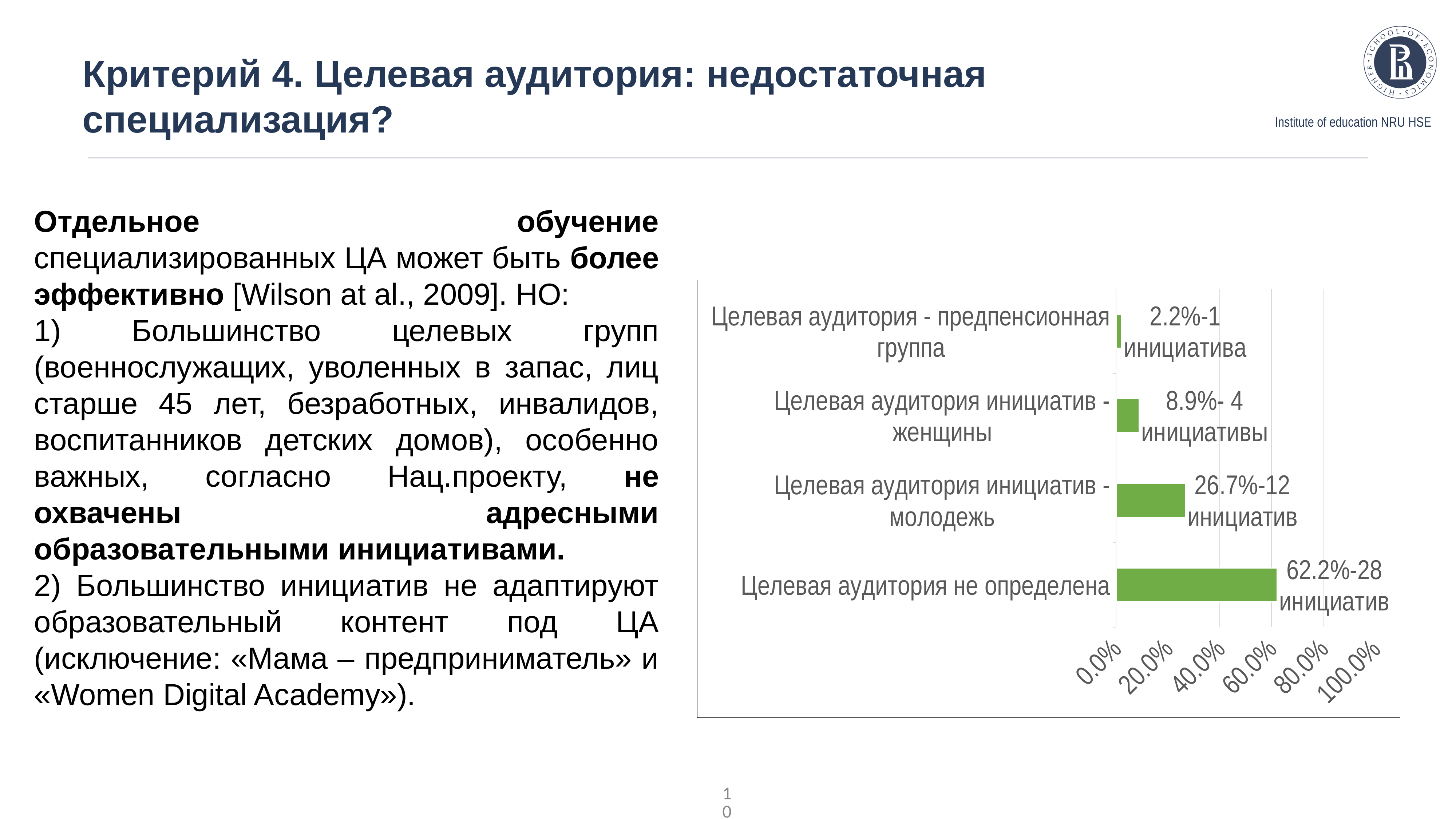
What kind of chart is shown on the slide? bar chart How many initiatives are shown for "Целевая аудитория - предпенсионная группа"? 1 How many more initiatives does "Целевая аудитория не определена" have than "Целевая аудитория инициатив - молодежь"? 16 Which category has the lowest value in the chart? Целевая аудитория - предпенсионная группа What percentage is shown for the category "Целевая аудитория не определена"? 62.2% What is the difference in percentage points between "Целевая аудитория не определена" and "Целевая аудитория инициатив - молодежь"? 35.5% Is the value for "Целевая аудитория не определена" greater or less than 60.0%? greater Which category has the highest value in the chart? Целевая аудитория не определена How many categories are shown in the chart? 4 How many initiatives are shown for "Целевая аудитория инициатив - молодежь"? 12 Which is larger: the value for "Целевая аудитория инициатив - женщины" or for "Целевая аудитория инициатив - молодежь"? Целевая аудитория инициатив - молодежь What percentage is shown for "Целевая аудитория инициатив - женщины"? 8.9%